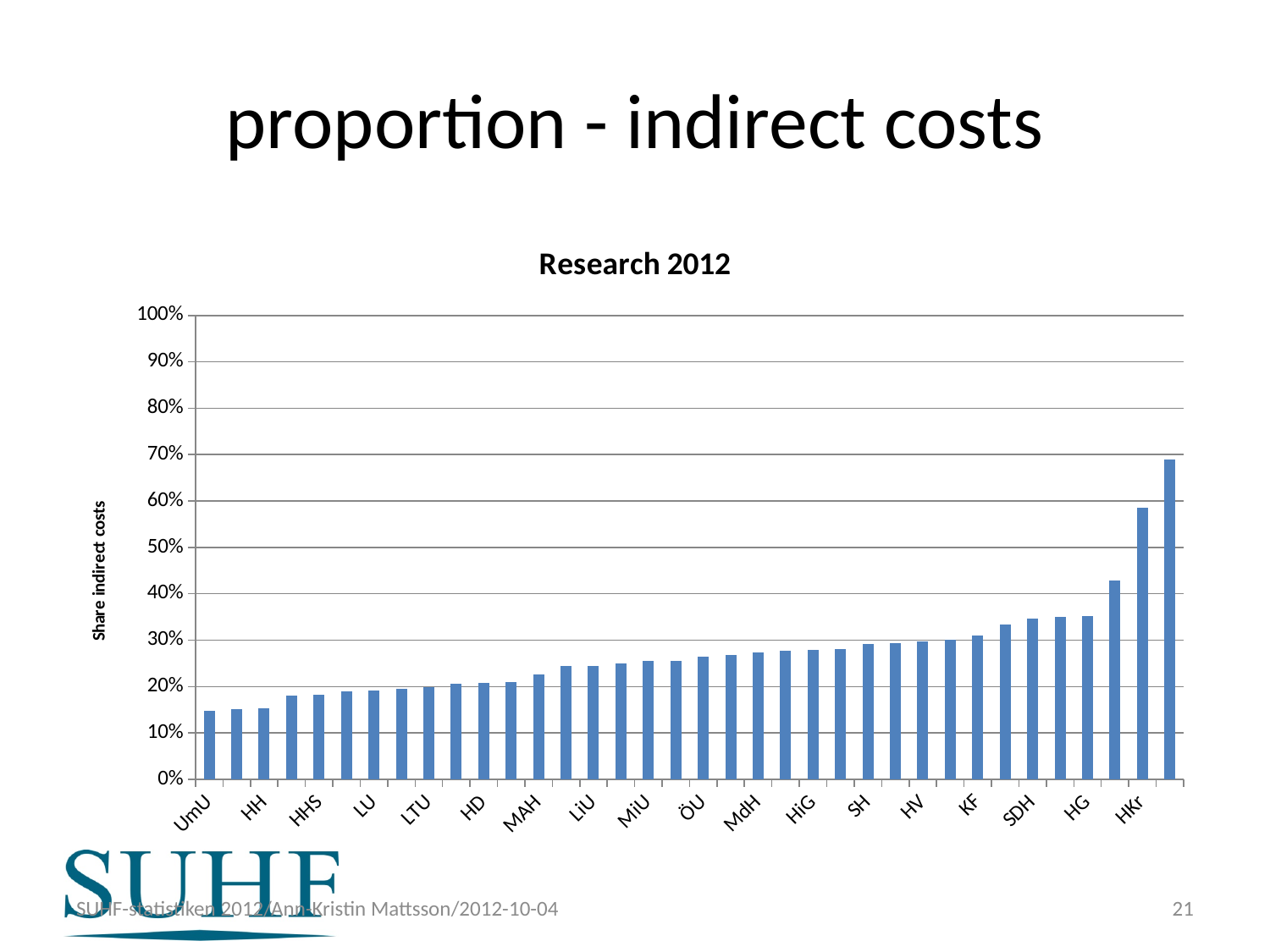
Is the value for HHS greater or less than 20%? less Is the value for SDH greater or less than 30%? greater What is the label on the vertical axis of the chart? Share indirect costs Do the bar values rise or fall from left to right along the x axis? rise What kind of chart is shown on the slide? bar chart Is the value for MiU greater or less than 30%? less Which has the larger value, HH or HG? HG Which has the larger value, HKr or UmU? HKr What is the title of the chart? Research 2012